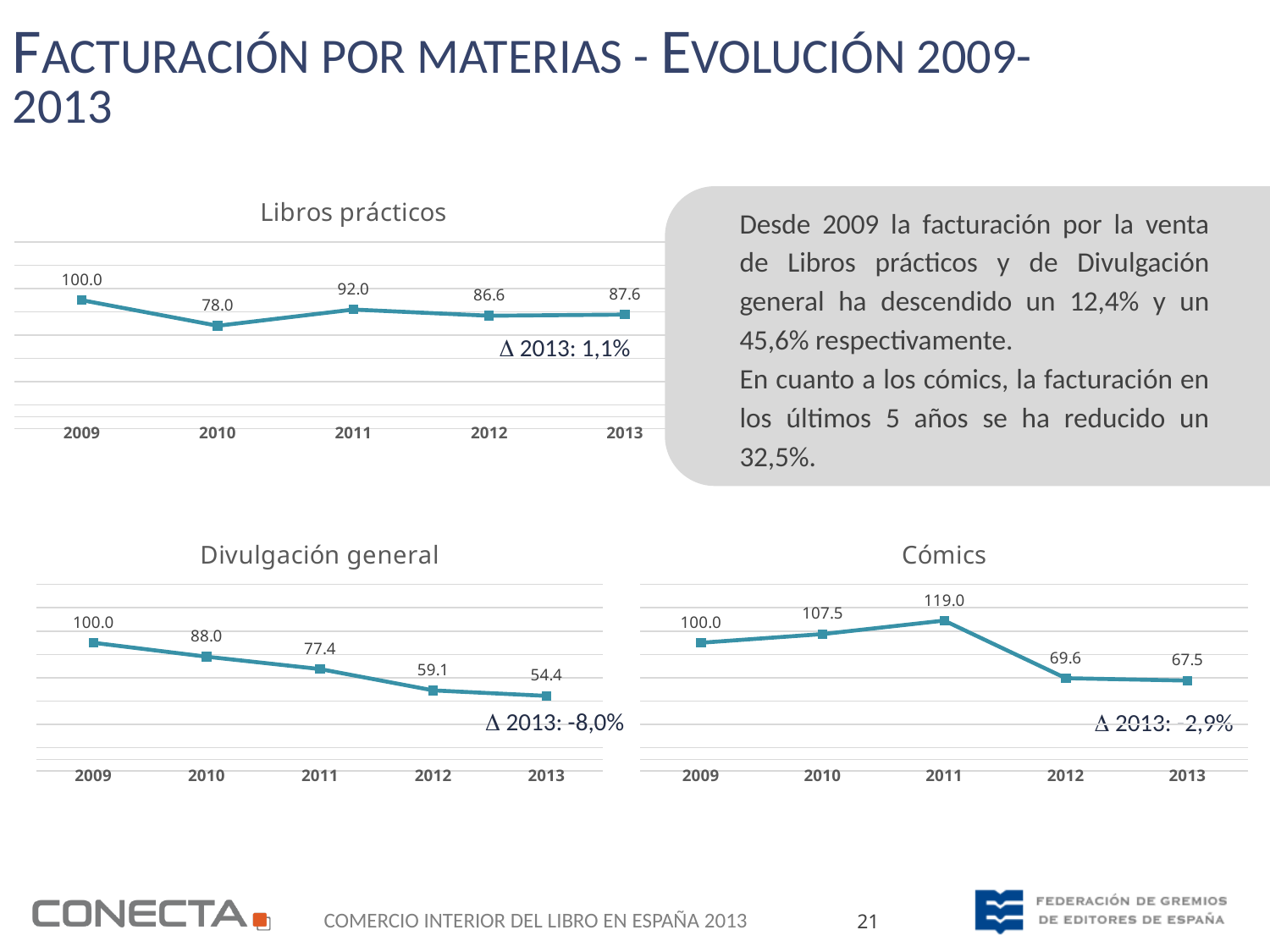
In the 'Divulgación general' chart, do the values rise or fall from 2009 to 2013? fall What is the title of the chart at the top left of the slide? Libros prácticos In the 'Libros prácticos' chart, which year has the lowest value? 2010 How many years are plotted in the 'Cómics' chart? 5 In the 'Divulgación general' chart, what is the value for 2013? 54.4 In the 'Cómics' chart, what is the value for 2012? 69.6 What kind of chart is the 'Divulgación general' chart? line chart In the 'Libros prácticos' chart, what is the value for 2010? 78.0 In the 'Cómics' chart, which year has the highest value? 2011 In the 'Cómics' chart, which is larger, the value for 2010 or the value for 2013? 2010 In the 'Libros prácticos' chart, what is the difference between the 2011 and 2012 values? 5.4 In the 'Divulgación general' chart, what is the difference between the 2009 and 2013 values? 45.6